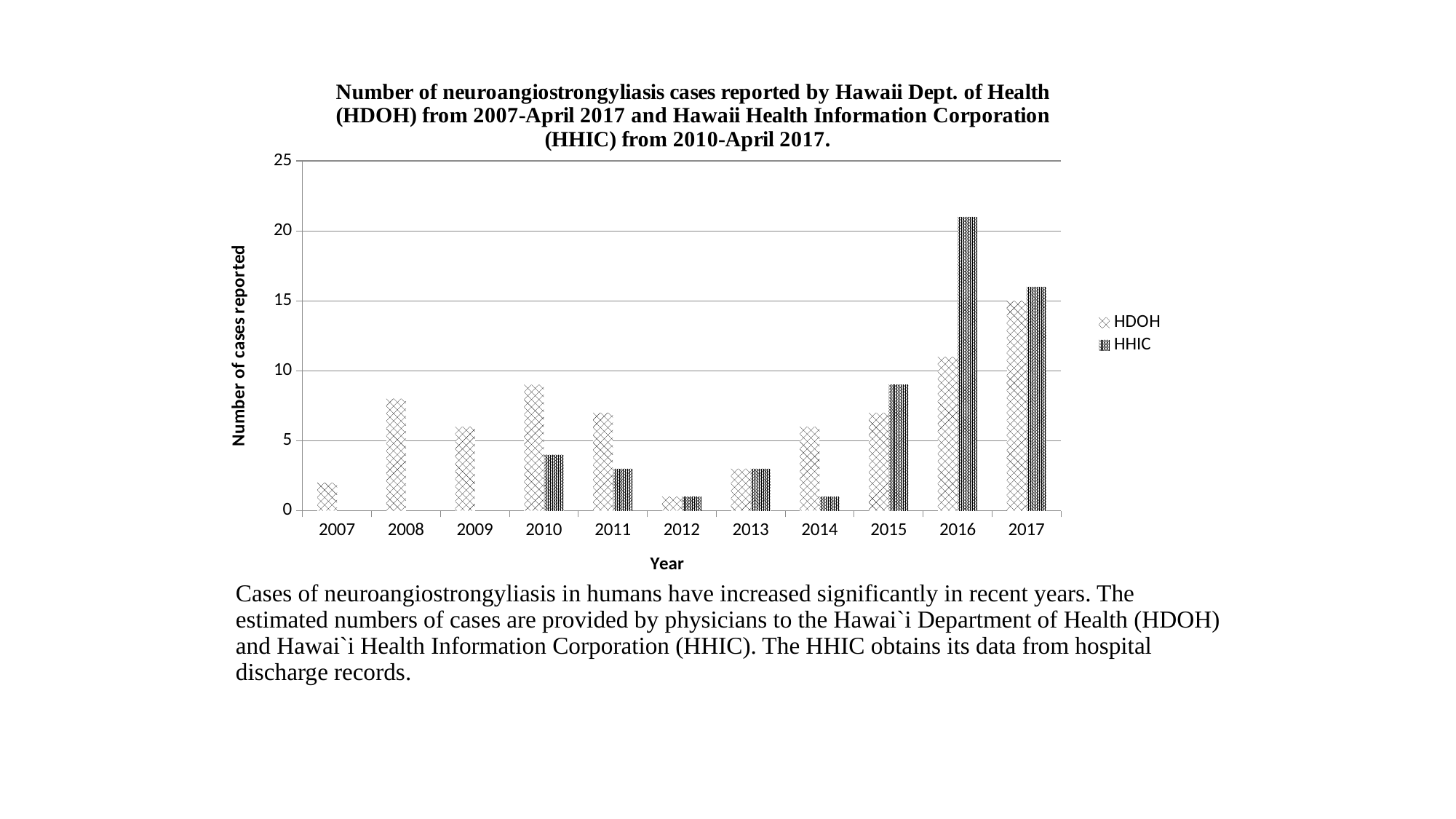
What is the title of the y axis? Number of cases reported Is the HDOH value for 2007 greater or less than 5? less In 2010, which series has the larger value, HDOH or HHIC? HDOH In which year is the HDOH value highest? 2017 In which year is the HHIC value highest? 2016 Is the HHIC value for 2016 greater or less than 20? greater Is the HDOH value for 2016 greater or less than 10? greater How many years are shown on the x axis? 11 What kind of chart is shown on the slide? bar chart How many series does the legend list? 2 In 2016, which series has the larger value, HDOH or HHIC? HHIC